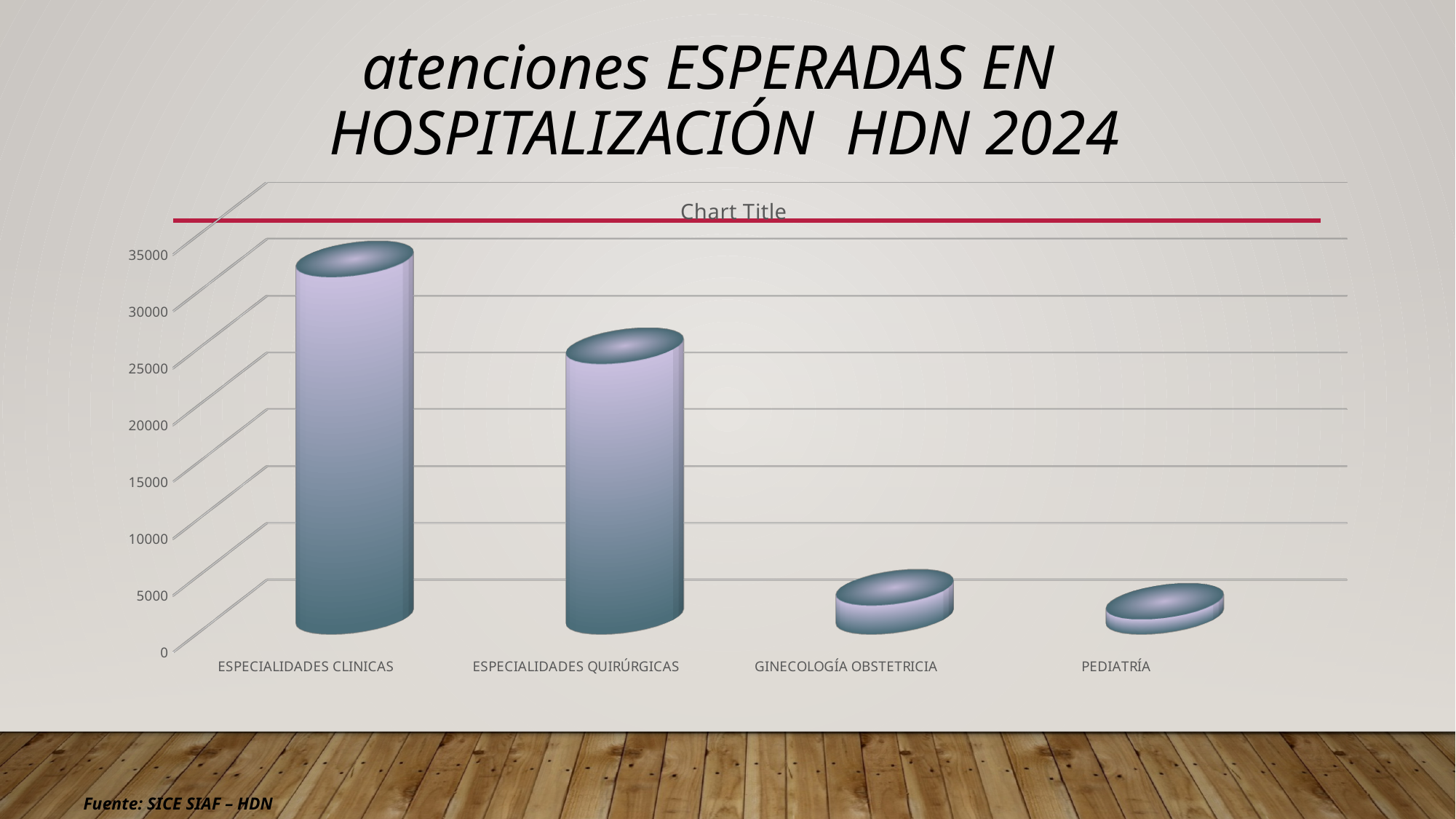
Which category has the highest value? ESPECIALIDADES CLINICAS What is the highest tick value shown on the vertical axis? 35000 Do the values rise or fall moving from left to right across the categories? fall Which is larger, the value for GINECOLOGÍA OBSTETRICIA or for PEDIATRÍA? GINECOLOGÍA OBSTETRICIA Is the value for ESPECIALIDADES CLINICAS greater or less than 30000? greater Is the value for GINECOLOGÍA OBSTETRICIA greater or less than 5000? less Which is larger, the value for ESPECIALIDADES CLINICAS or for ESPECIALIDADES QUIRÚRGICAS? ESPECIALIDADES CLINICAS Which category has the lowest value? PEDIATRÍA What kind of chart is shown on the slide? bar chart Is the value for ESPECIALIDADES QUIRÚRGICAS greater or less than 20000? greater How many categories are plotted on the chart? 4